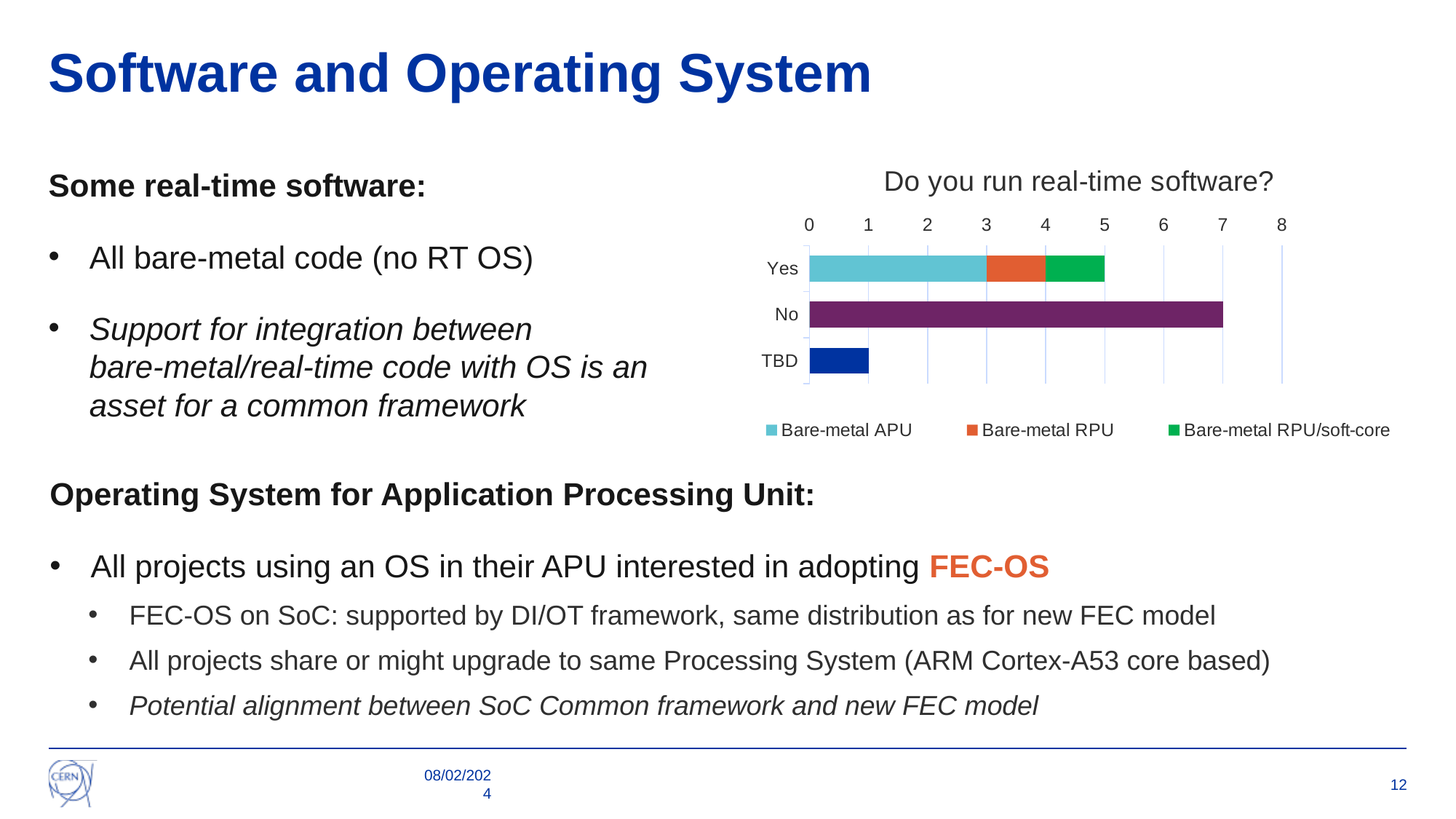
What is the title of the chart? Do you run real-time software? How many series does the chart's legend list? 3 Which category has the shortest bar in the chart? TBD What value does the bar for 'TBD' reach on the axis? 1 What is the total length of the stacked bar for 'Yes'? 5 How many categories are shown on the chart's vertical axis? 3 What is the value of the Bare-metal APU segment in the 'Yes' bar? 3 Is the value for 'No' greater or less than 6? greater What kind of chart is shown on the slide? bar chart Is the bar for 'No' longer or shorter than the stacked bar for 'Yes'? longer What value does the bar for 'No' reach on the axis? 7 Which category has the longest bar in the chart? No